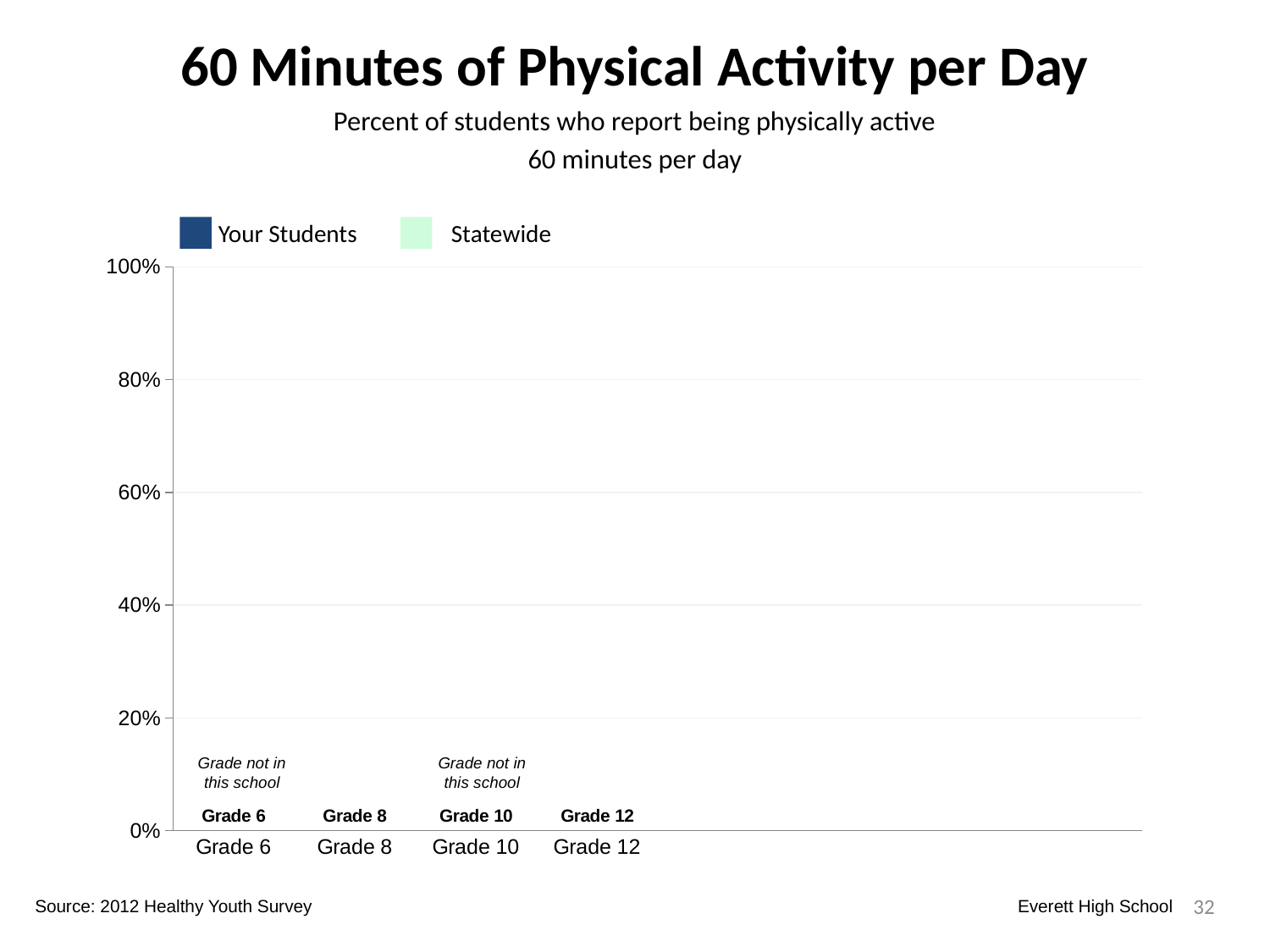
How many grade categories are shown on the x axis? 4 Which grades are marked as 'Grade not in this school'? Grade 6 and Grade 10 What is the highest value shown on the y axis? 100% What is the title of the chart? 60 Minutes of Physical Activity per Day What are the two series named in the legend? Your Students and Statewide How many series does the legend list? 2